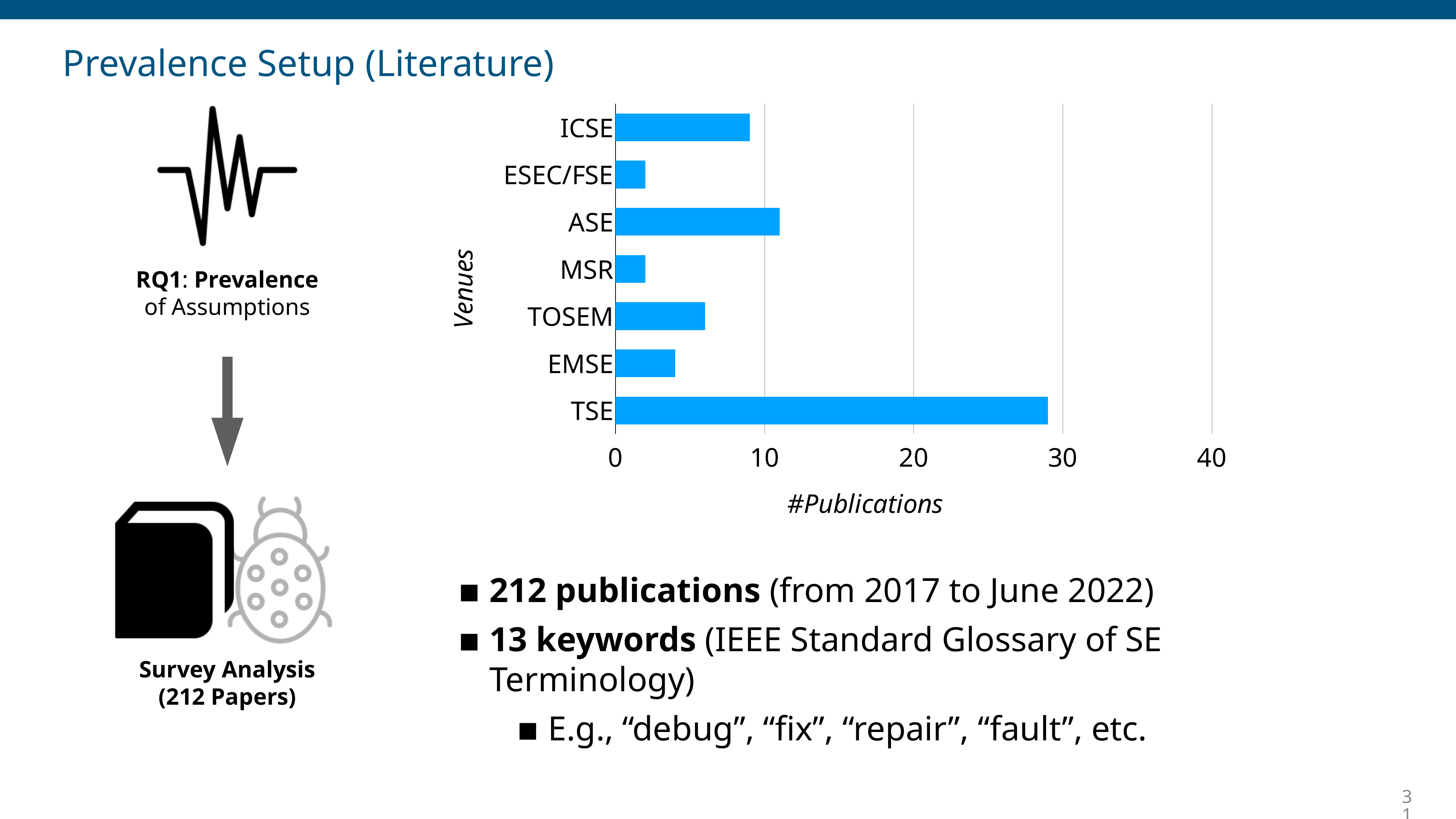
What kind of chart is shown on the slide? bar chart Is the value for ICSE greater or less than 10? less Is the value for TSE greater or less than 30? less Is the value for TOSEM greater or less than 10? less How many venues are shown on the chart? 7 Which has more publications, ICSE or TOSEM? ICSE Which venue has the highest number of publications? TSE What is the label of the vertical axis of the chart? Venues What is the label of the horizontal axis of the chart? #Publications Which has more publications, TSE or ASE? TSE